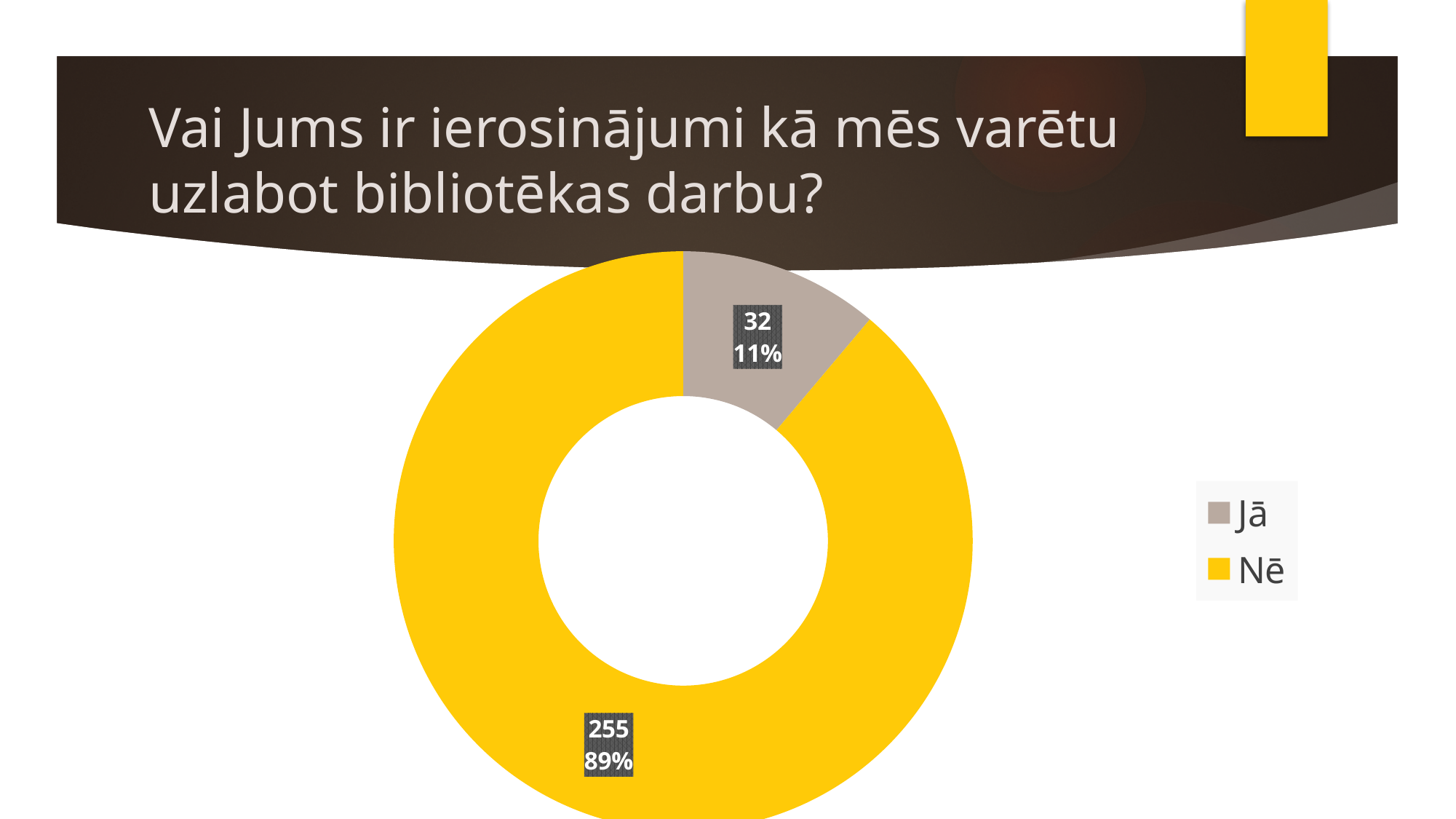
How many respondents answered "Nē"? 255 What is the difference between the counts for "Nē" and "Jā"? 223 How many respondents answered "Jā"? 32 Which category has the smallest slice? Jā Which category has the largest slice? Nē How many categories does the chart show? 2 What kind of chart is shown on the slide? Doughnut chart Which is larger, the count for "Jā" or the count for "Nē"? Nē What percentage share does the "Jā" slice have? 11% What colour is the "Nē" slice? Yellow What percentage share does the "Nē" slice have? 89% What is the total number of responses across both slices? 287